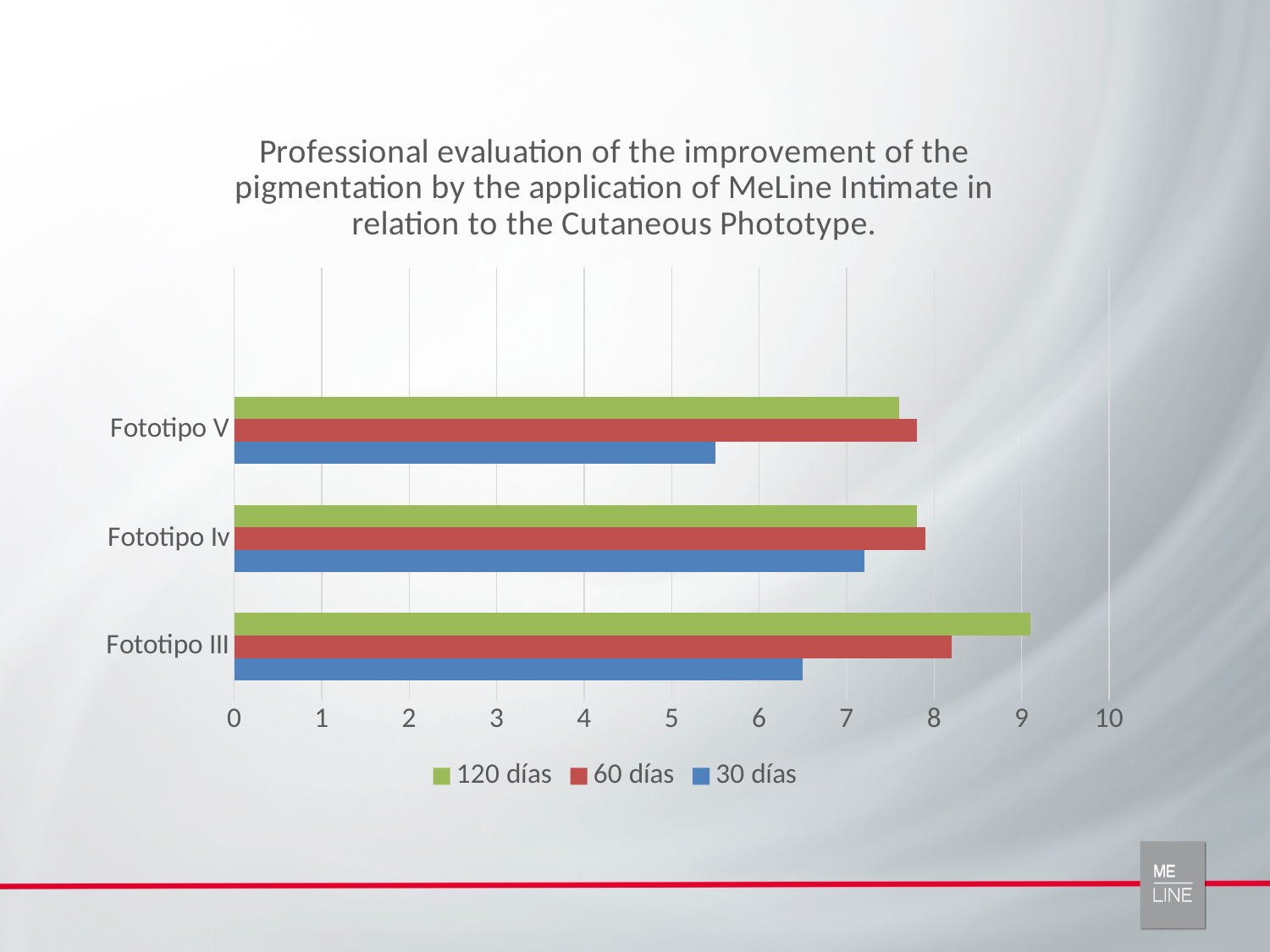
Which series is shown in green in the legend? 120 días For 30 días, which is larger: the value for Fototipo V or for Fototipo Iv? Fototipo Iv How many series does the legend list? 3 Is the value for 60 días for Fototipo III greater or less than 8? greater What kind of chart is shown on the slide? bar chart Which phototype has the lowest value for 30 días? Fototipo V Which phototype has the highest value for 120 días? Fototipo III Is the value for 30 días for Fototipo Iv greater or less than 7? greater Is the value for 120 días for Fototipo III greater or less than 9? greater For 120 días, which is larger: the value for Fototipo III or for Fototipo V? Fototipo III How many categories (phototypes) are shown on the chart? 3